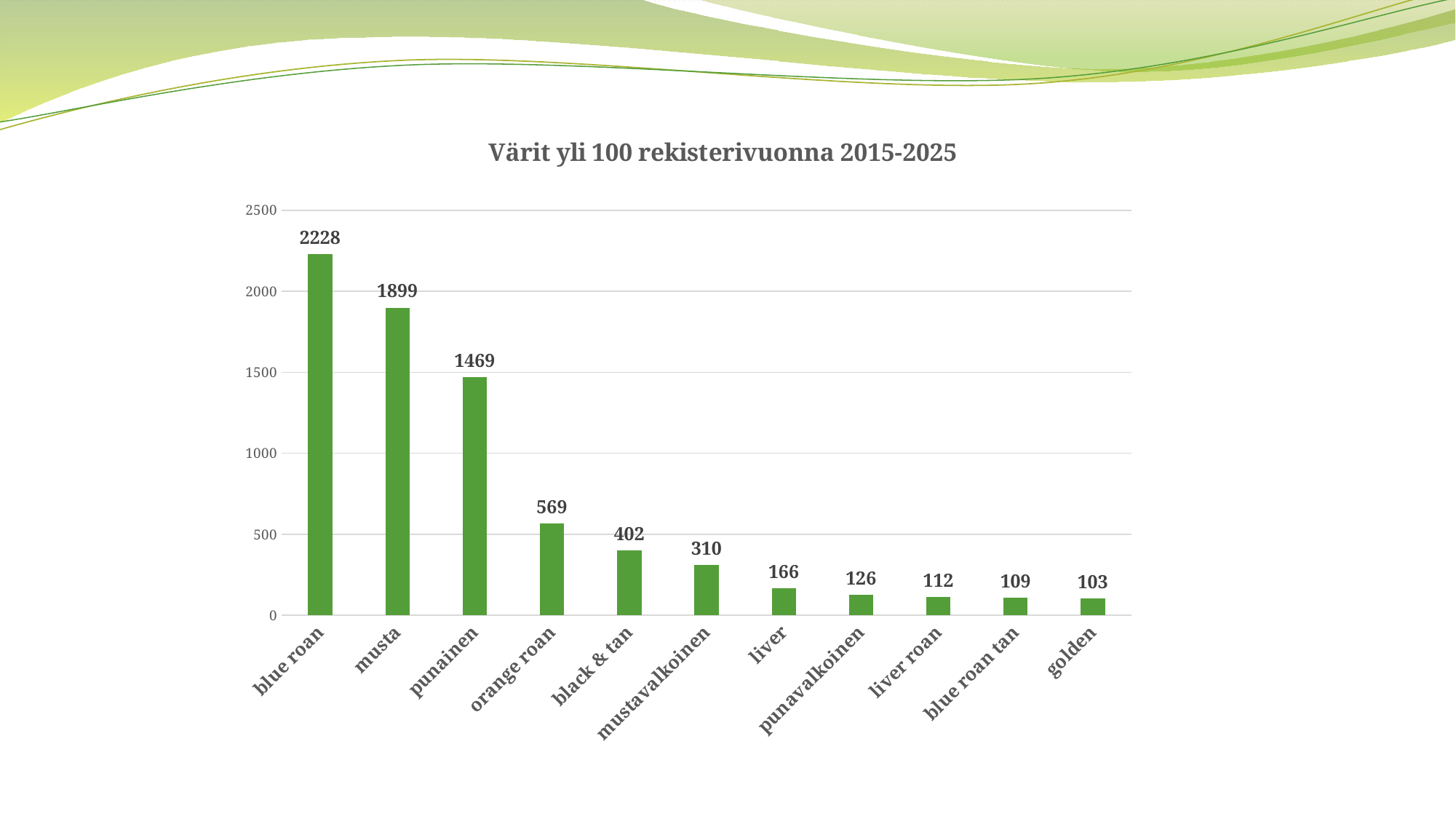
Which is larger, the value for orange roan or the value for black & tan? orange roan Is the value for punainen greater or less than 1000? greater What is the difference between the values for musta and punainen? 430 What is the title of the chart? Värit yli 100 rekisterivuonna 2015-2025 What is the value for mustavalkoinen? 310 What kind of chart is shown on the slide? bar chart Which category has the lowest value? golden What is the value for liver roan? 112 Which category has the highest value? blue roan How many categories are shown on the x axis? 11 Do the values rise or fall from left to right along the x axis? fall What is the value for blue roan? 2228